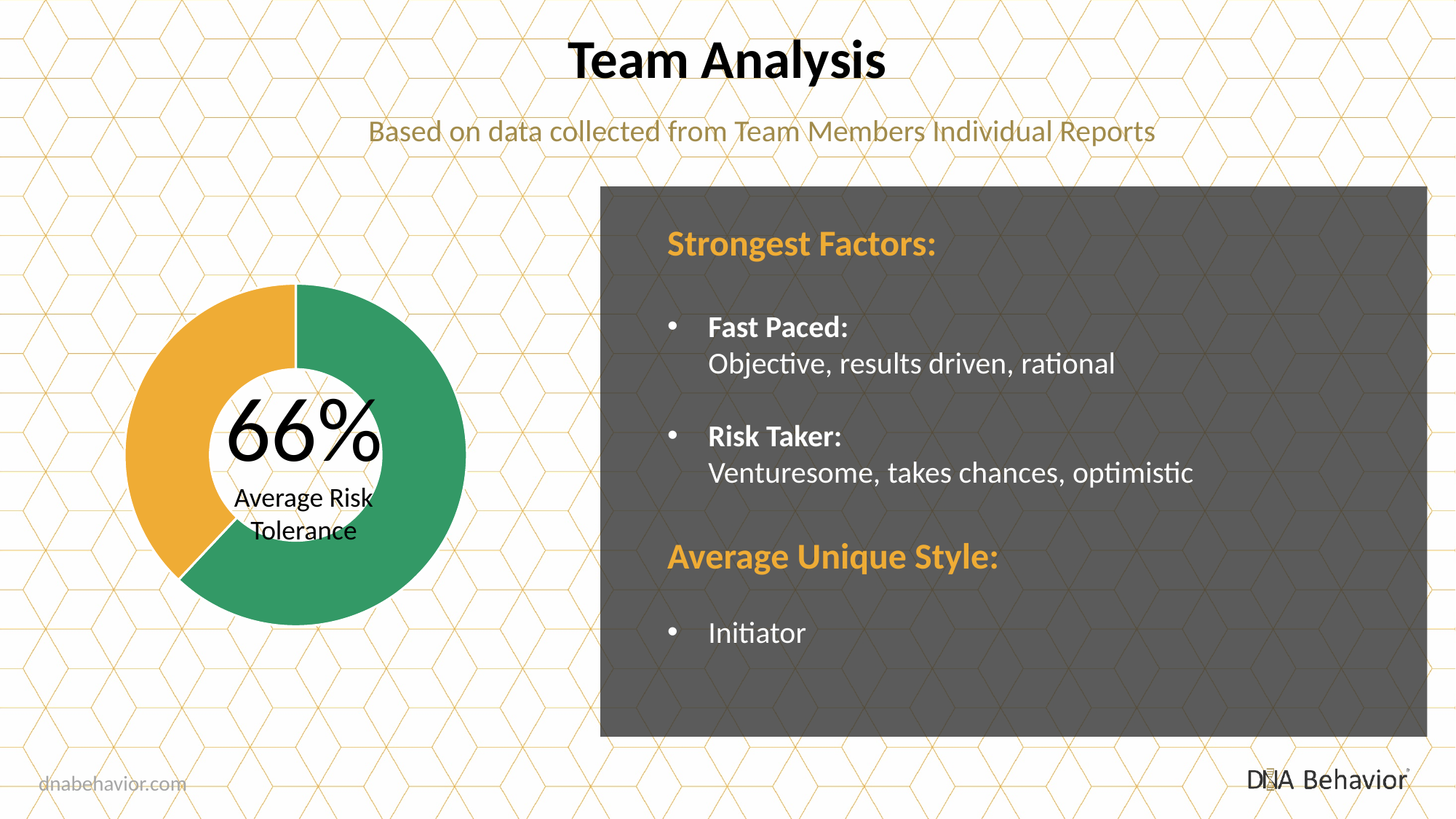
What value is printed in the centre of the donut chart? 66% What does the 66% in the donut chart represent, according to the label beneath it? Average Risk Tolerance Is the green segment of the donut chart more or less than half of the ring? More Which colour is used for the smaller segment of the donut chart? Orange Which segment of the donut chart is larger, the green one or the orange one? Green What kind of chart is shown on the left of the slide? Donut chart How many segments does the donut chart have? 2